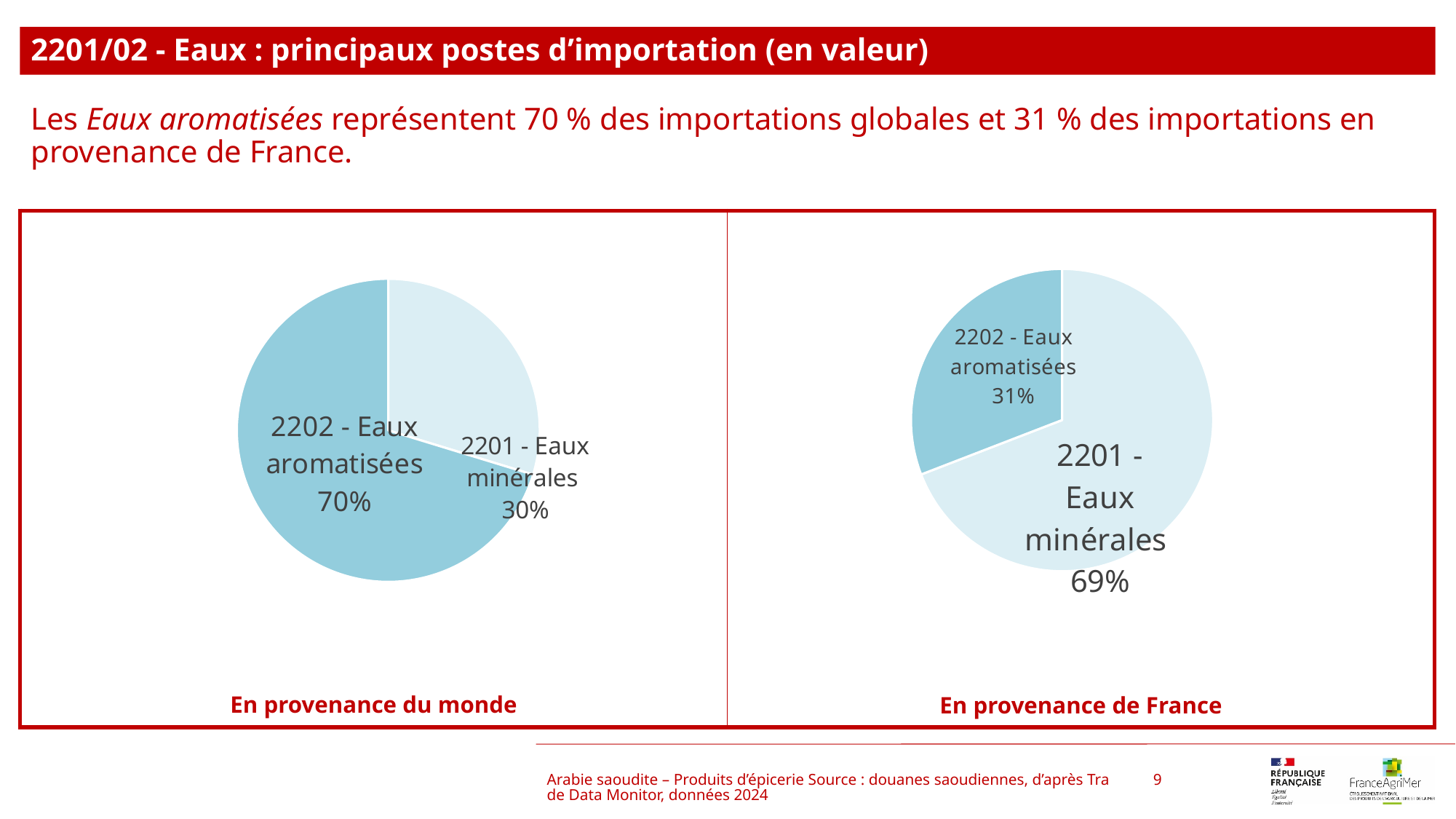
In the 'En provenance du monde' chart, which category has the largest slice? 2202 - Eaux aromatisées How many charts are shown on the slide? 2 In the 'En provenance du monde' chart, what share does '2202 - Eaux aromatisées' have? 70% In the 'En provenance du monde' chart, what share does '2201 - Eaux minérales' have? 30% In the 'En provenance de France' chart, what is the difference between the shares of '2201 - Eaux minérales' and '2202 - Eaux aromatisées'? 38 percentage points In the 'En provenance de France' chart, what share does '2202 - Eaux aromatisées' have? 31% What kind of chart is the 'En provenance du monde' chart? Pie chart In the 'En provenance du monde' chart, what is the difference between the shares of '2202 - Eaux aromatisées' and '2201 - Eaux minérales'? 40 percentage points How many categories does the 'En provenance de France' chart show? 2 In the 'En provenance de France' chart, which is larger: '2201 - Eaux minérales' or '2202 - Eaux aromatisées'? 2201 - Eaux minérales In the 'En provenance de France' chart, which category has the smallest slice? 2202 - Eaux aromatisées